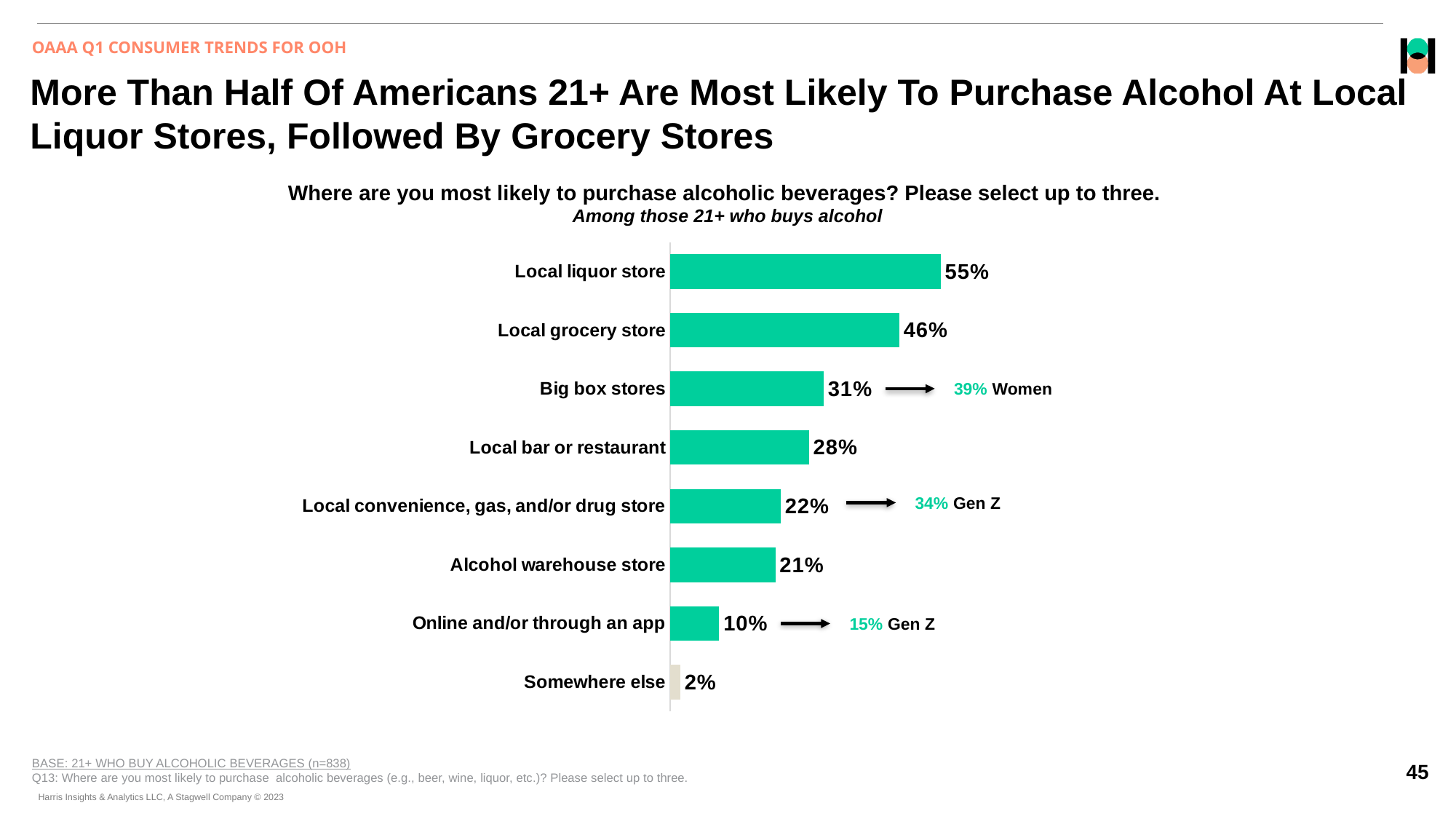
What percentage is shown for Alcohol warehouse store? 21% How many categories are shown in the chart? 8 What percentage of respondents said they are most likely to purchase alcohol at a local liquor store? 55% What is the difference between the values for Local liquor store and Local grocery store? 9% What is the difference between Big box stores and Local bar or restaurant? 3% Which category has the lowest value? Somewhere else What kind of chart is shown on the slide? Bar chart Which bar is shown in a different colour from the others? Somewhere else Which category has the highest value? Local liquor store What percentage of Gen Z said they are most likely to purchase alcohol online and/or through an app, according to the callout? 15% What is the value for Local grocery store? 46% Which is larger, the value for Local convenience, gas, and/or drug store or the value for Online and/or through an app? Local convenience, gas, and/or drug store